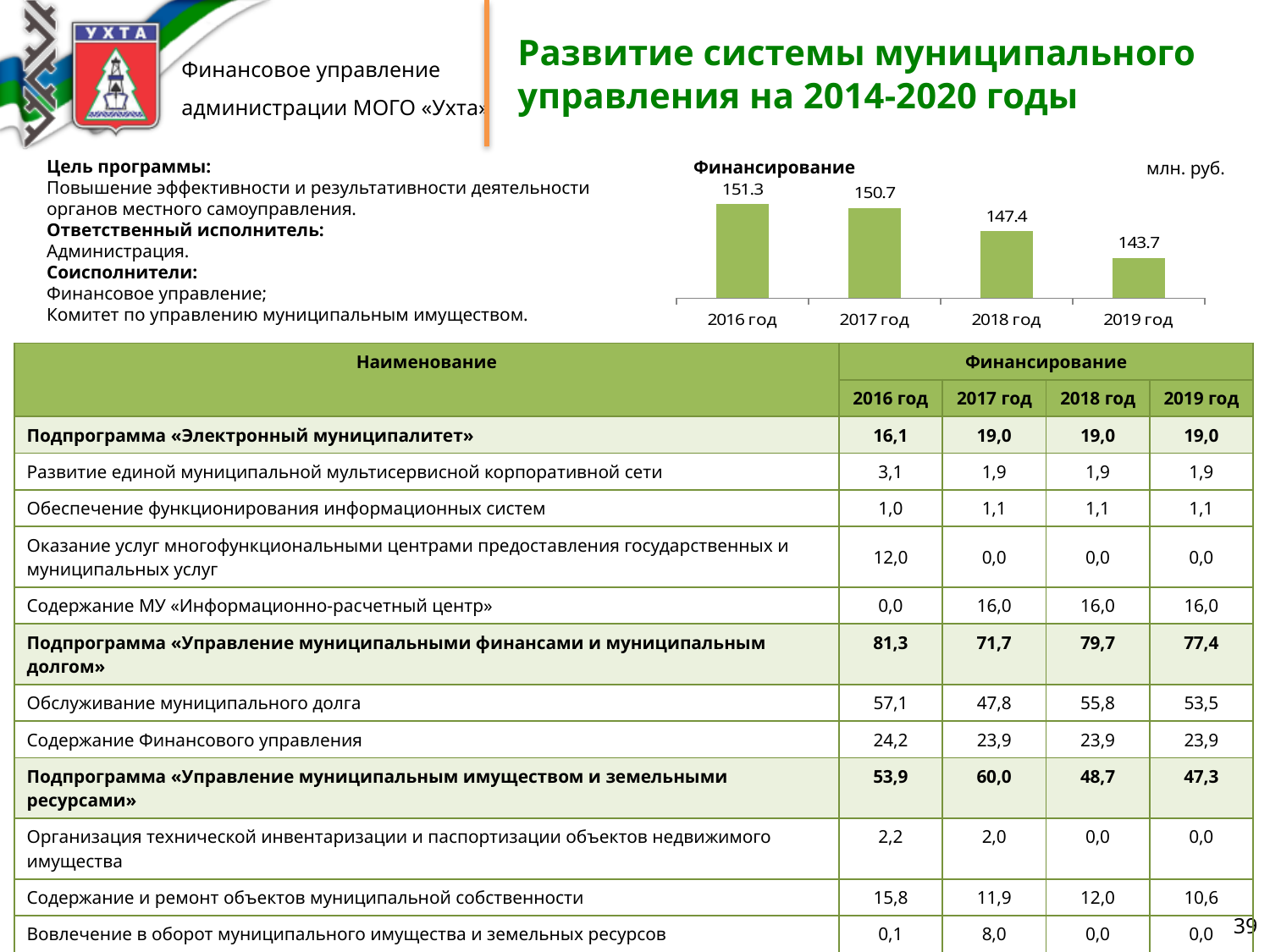
How many years are shown in the Финансирование chart? 4 What is the value for 2019 год in the Финансирование chart? 143.7 What is the difference between the values for 2016 год and 2019 год in the Финансирование chart? 7.6 What is the value for 2018 год in the Финансирование chart? 147.4 What is the difference between the values for 2017 год and 2018 год in the Финансирование chart? 3.3 What unit is indicated for the values in the Финансирование chart? млн. руб. Which is larger in the Финансирование chart, the value for 2017 год or 2018 год? 2017 год What kind of chart is the Финансирование chart? bar chart Do the values in the Финансирование chart rise or fall from 2016 год to 2019 год? fall What is the value for 2016 год in the Финансирование chart? 151.3 Which year has the highest value in the Финансирование chart? 2016 год Which year has the lowest value in the Финансирование chart? 2019 год